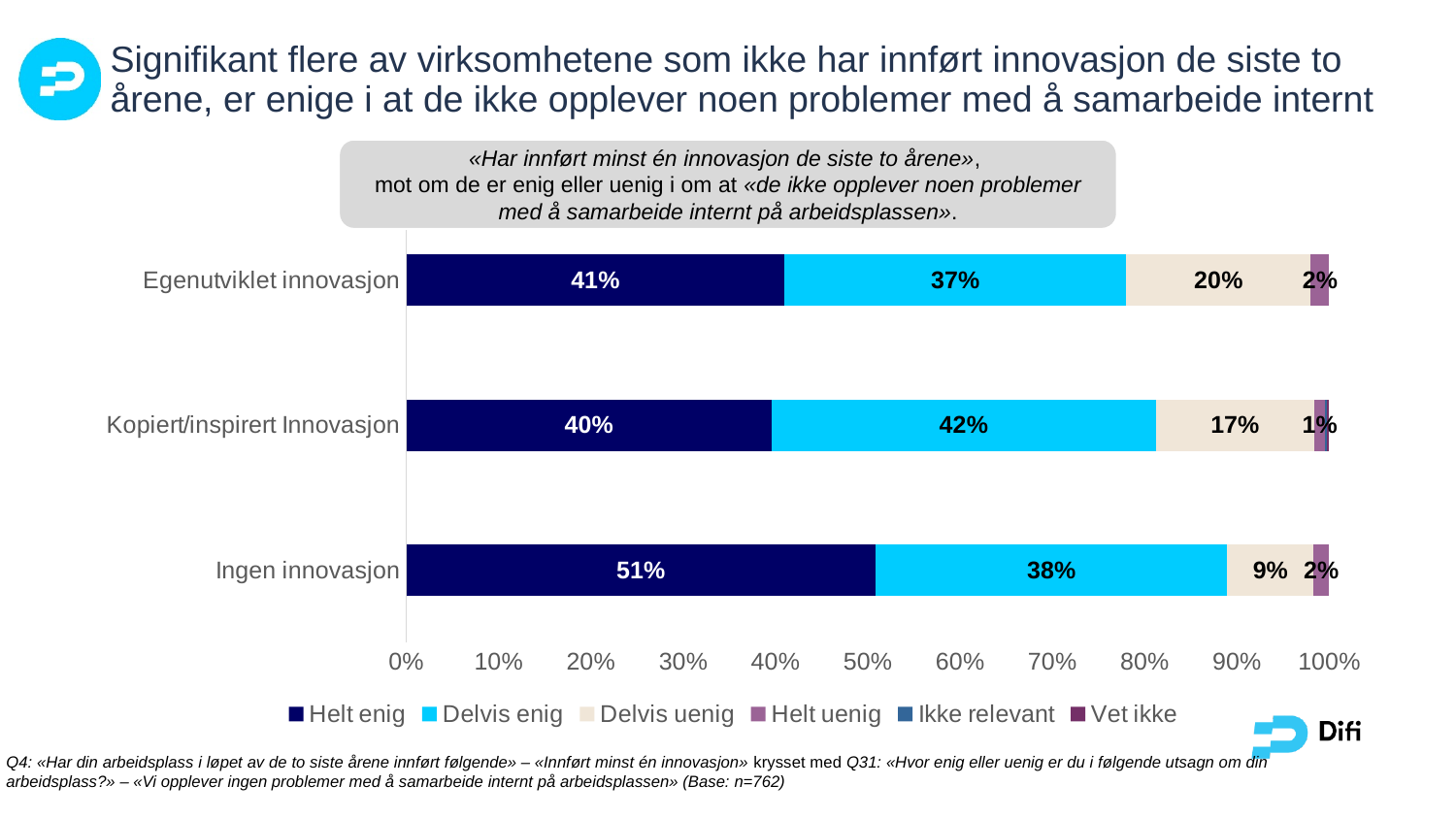
What is the 'Helt enig' value for 'Ingen innovasjon'? 51% Which category has the lowest 'Delvis uenig' share? Ingen innovasjon What kind of chart is shown on the slide? Stacked bar chart How many series does the legend list? 6 Which category has the highest 'Helt enig' share? Ingen innovasjon Is the 'Helt enig' value for 'Egenutviklet innovasjon' greater or less than 50%? less What is the difference in 'Helt enig' share between 'Ingen innovasjon' and 'Egenutviklet innovasjon'? 10 percentage points What is the 'Delvis uenig' value for 'Egenutviklet innovasjon'? 20% What is the 'Delvis enig' value for 'Kopiert/inspirert Innovasjon'? 42% Which has the larger 'Delvis enig' share: 'Egenutviklet innovasjon' or 'Kopiert/inspirert Innovasjon'? Kopiert/inspirert Innovasjon What is the first entry in the chart's legend? Helt enig How many categories (bars) are shown in the chart? 3